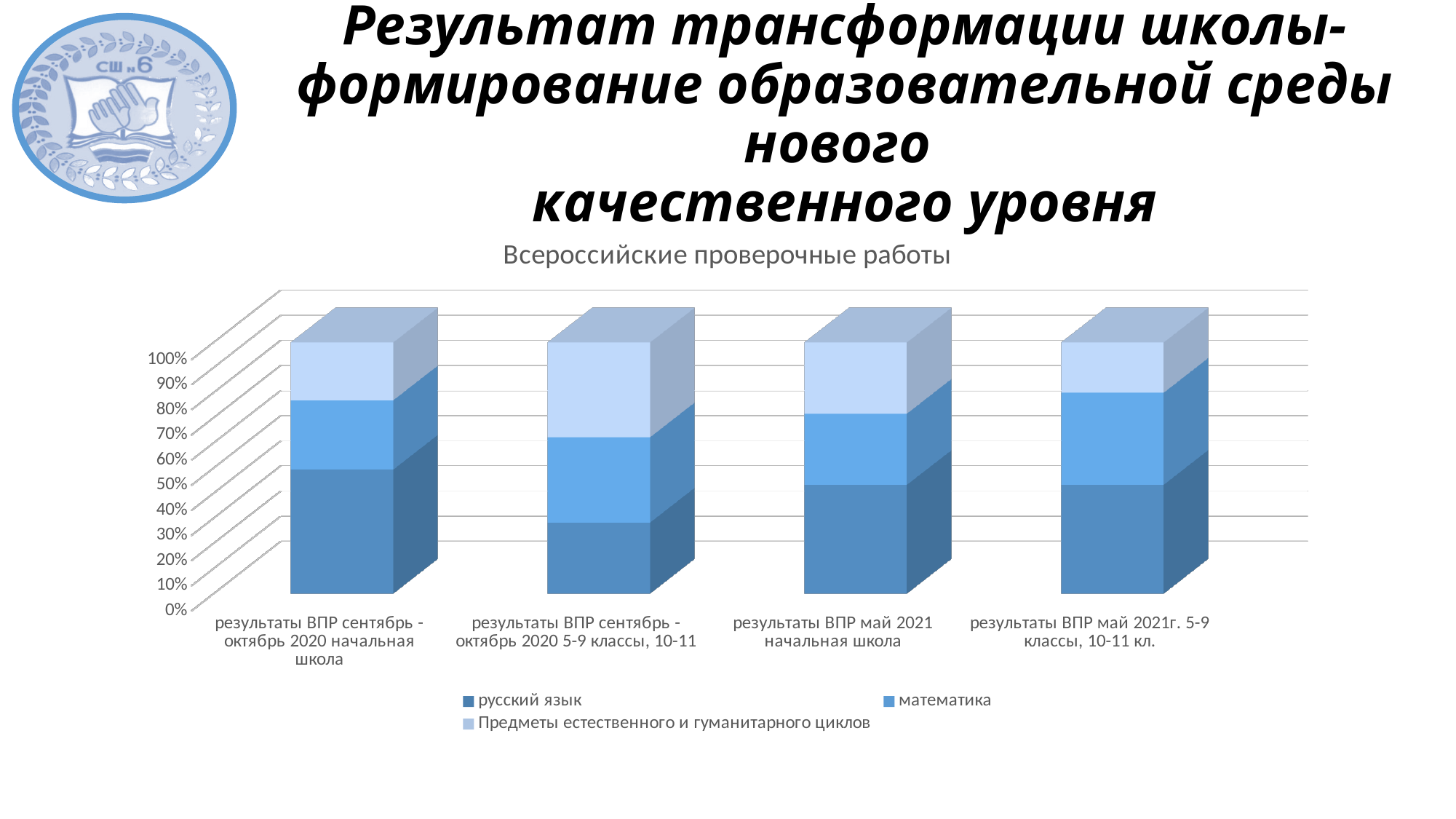
How many categories are shown on the x axis of the chart? 4 In which category is the русский язык segment the smallest? результаты ВПР сентябрь - октябрь 2020 5-9 классы, 10-11 How many series does the chart legend list? 3 What is the title of the chart? Всероссийские проверочные работы Which series is listed last in the chart legend? Предметы естественного и гуманитарного циклов What do the three segments of each stacked bar add up to? 100% In which category is the Предметы естественного и гуманитарного циклов segment the largest? результаты ВПР сентябрь - октябрь 2020 5-9 классы, 10-11 Is the русский язык share for результаты ВПР сентябрь - октябрь 2020 начальная школа greater or less than 40%? greater Is the Предметы естественного и гуманитарного циклов share for результаты ВПР сентябрь - октябрь 2020 5-9 классы, 10-11 greater or less than 30%? greater What type of chart is shown on the slide? bar chart Is the русский язык share for результаты ВПР сентябрь - октябрь 2020 5-9 классы, 10-11 greater or less than 40%? less Which has the larger русский язык share: результаты ВПР сентябрь - октябрь 2020 начальная школа or результаты ВПР сентябрь - октябрь 2020 5-9 классы, 10-11? результаты ВПР сентябрь - октябрь 2020 начальная школа